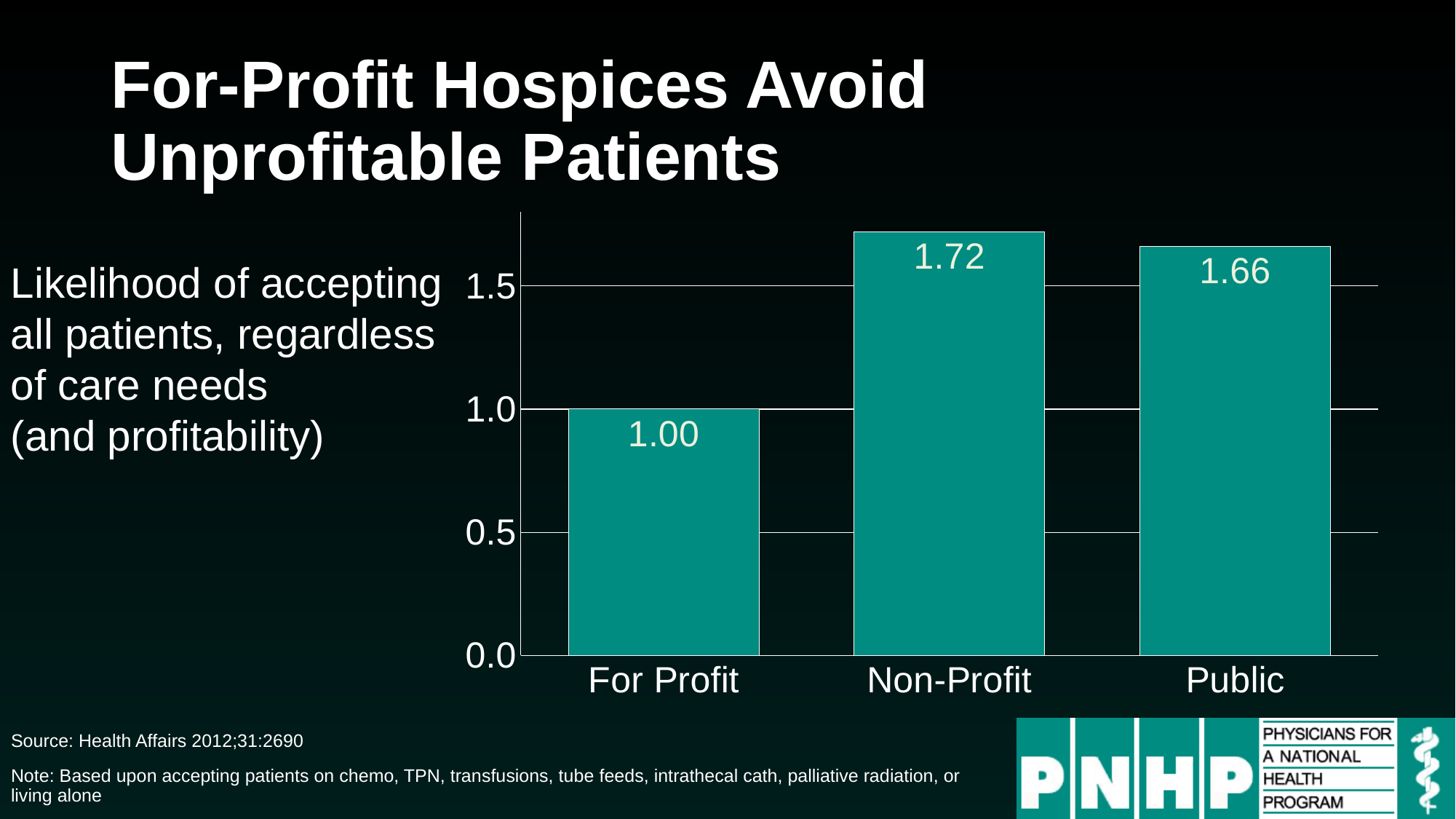
What is the difference between the values for Non-Profit and Public? 0.06 What is the title of the slide containing the chart? For-Profit Hospices Avoid Unprofitable Patients What is the difference between the values for Non-Profit and For Profit? 0.72 Which category has the lowest value? For Profit What is the value for Non-Profit? 1.72 Which category has the highest value? Non-Profit How many categories are shown on the x axis? 3 What is the value for For Profit? 1.00 Which is larger, the value for Public or the value for For Profit? Public Is the value for Public greater or less than 1.5? greater What kind of chart is shown on the slide? bar chart What is the value for Public? 1.66